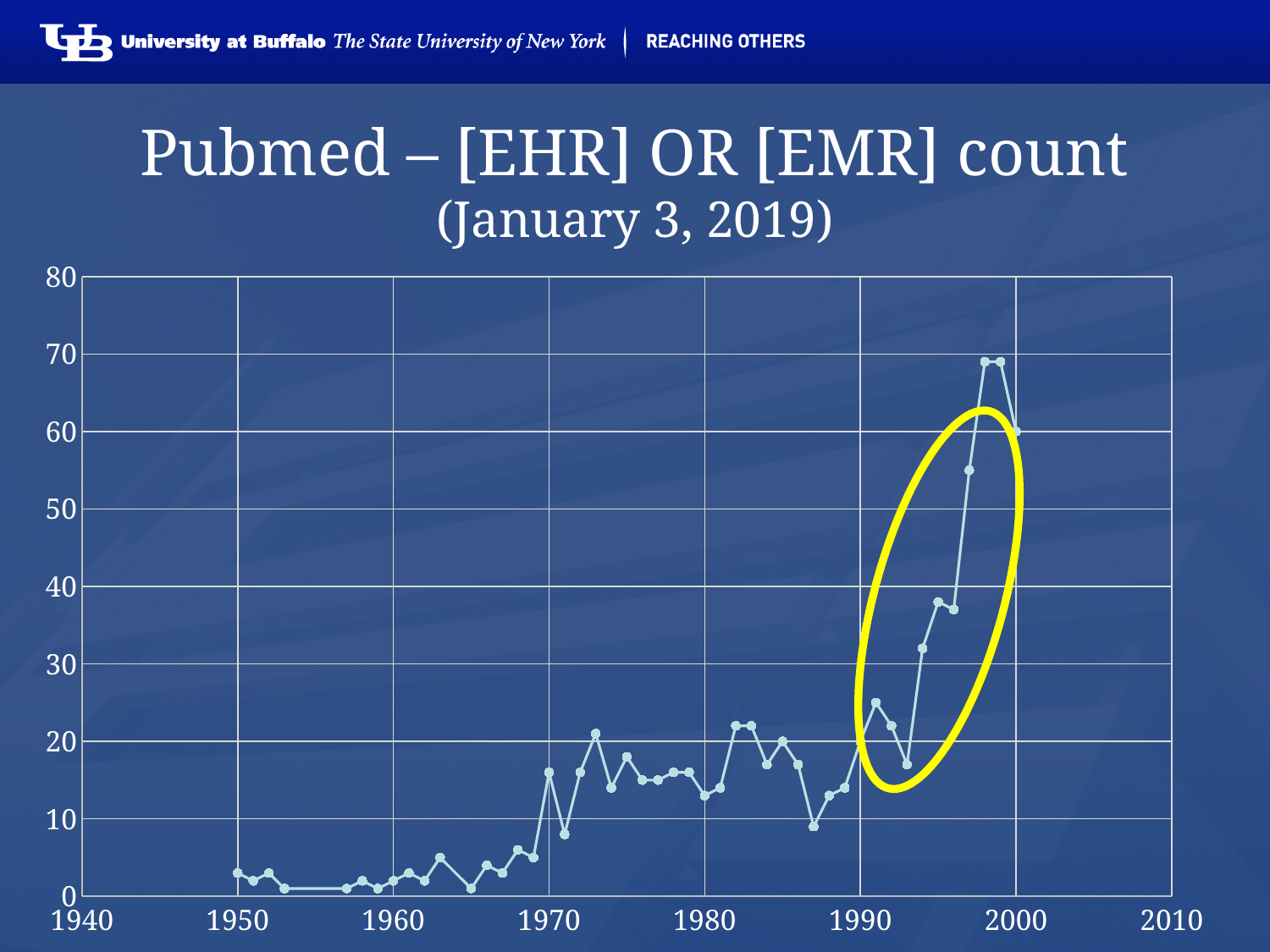
What kind of chart is shown on the slide? line chart Is the value for 1991 greater or less than 20? greater Is the value for 1997 greater or less than 50? greater Is the value for 1980 greater or less than 20? less Overall, do the values rise or fall from 1950 to 2000? rise Which decade is highlighted by the yellow ellipse on the chart? the 1990s What is the title of the chart? Pubmed – [EHR] OR [EMR] count (January 3, 2019)